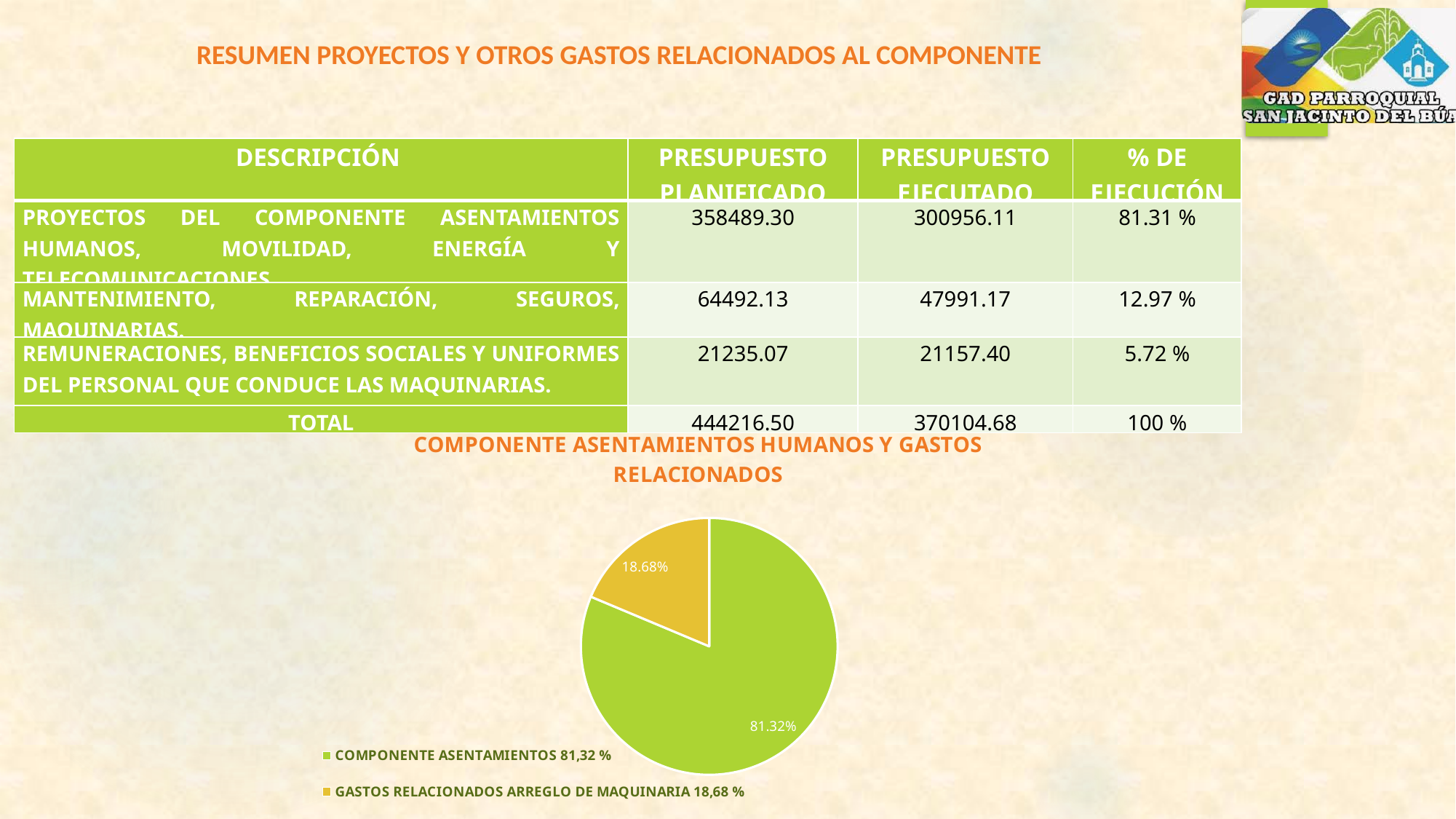
What colour is the GASTOS RELACIONADOS ARREGLO DE MAQUINARIA slice in the pie chart? gold How many slices does the pie chart have? 2 Which slice of the pie chart is the largest? COMPONENTE ASENTAMIENTOS What share of the pie is labelled for GASTOS RELACIONADOS ARREGLO DE MAQUINARIA? 18.68% What share of the pie is labelled for COMPONENTE ASENTAMIENTOS? 81.32% What kind of chart is shown on the slide? pie chart Which slice of the pie chart is the smallest? GASTOS RELACIONADOS ARREGLO DE MAQUINARIA How many entries does the pie chart's legend list? 2 Which is larger in the pie chart: COMPONENTE ASENTAMIENTOS or GASTOS RELACIONADOS ARREGLO DE MAQUINARIA? COMPONENTE ASENTAMIENTOS What is the difference in percentage points between the COMPONENTE ASENTAMIENTOS slice and the GASTOS RELACIONADOS ARREGLO DE MAQUINARIA slice? 62.64 What is the title of the pie chart? COMPONENTE ASENTAMIENTOS HUMANOS Y GASTOS RELACIONADOS